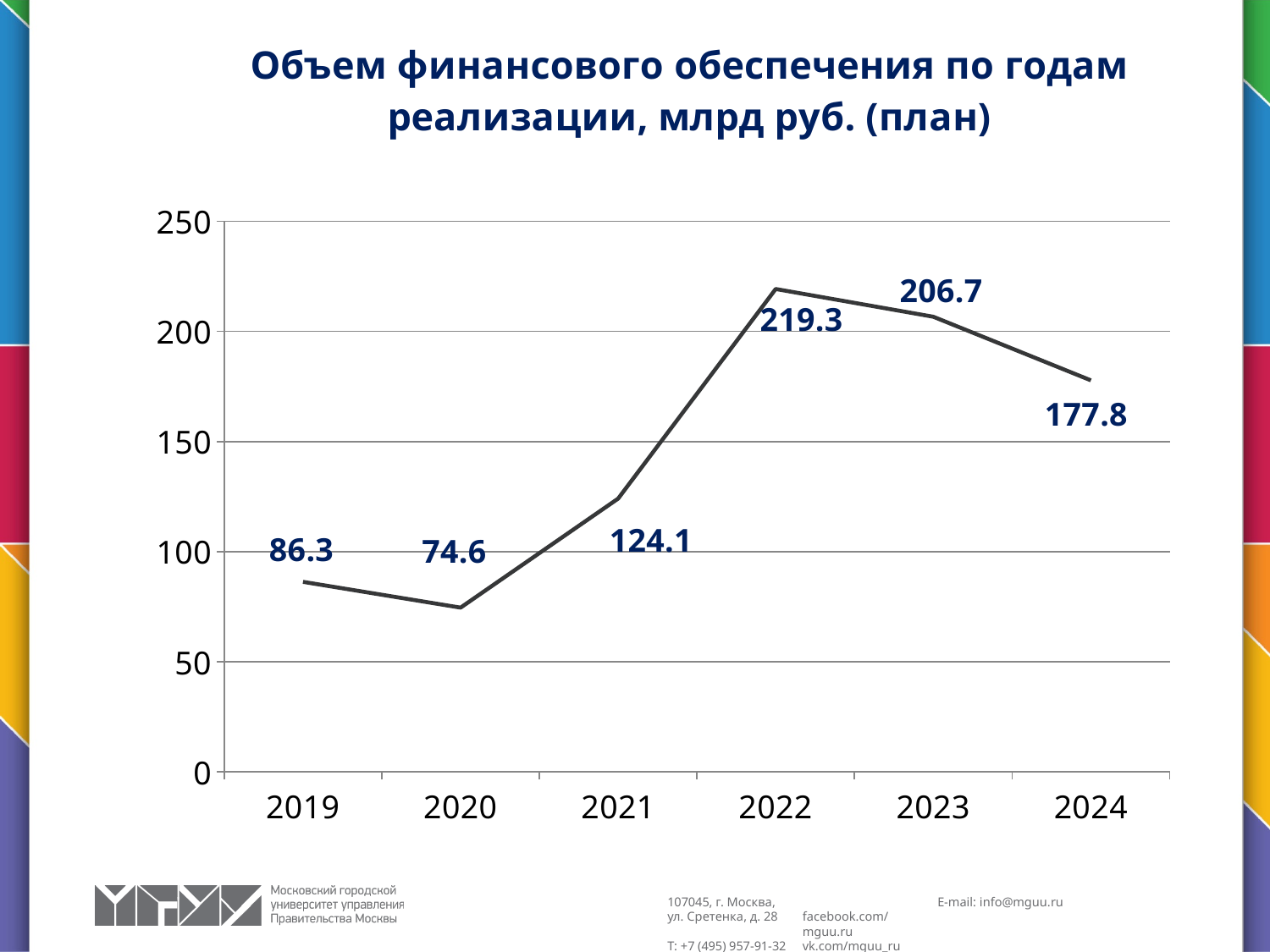
Does the value rise or fall from 2022 to 2024? fall What is the difference between the values for 2022 and 2023? 12.6 What is the difference between the values for 2019 and 2020? 11.7 Which year has the highest value? 2022 What is the value for 2022? 219.3 What kind of chart is shown on the slide? line chart What is the value for 2024? 177.8 What is the value for 2020? 74.6 Which is larger, the value for 2023 or the value for 2024? 2023 Is the value for 2021 greater or less than 100? greater Which year has the lowest value? 2020 How many years are plotted on the chart? 6